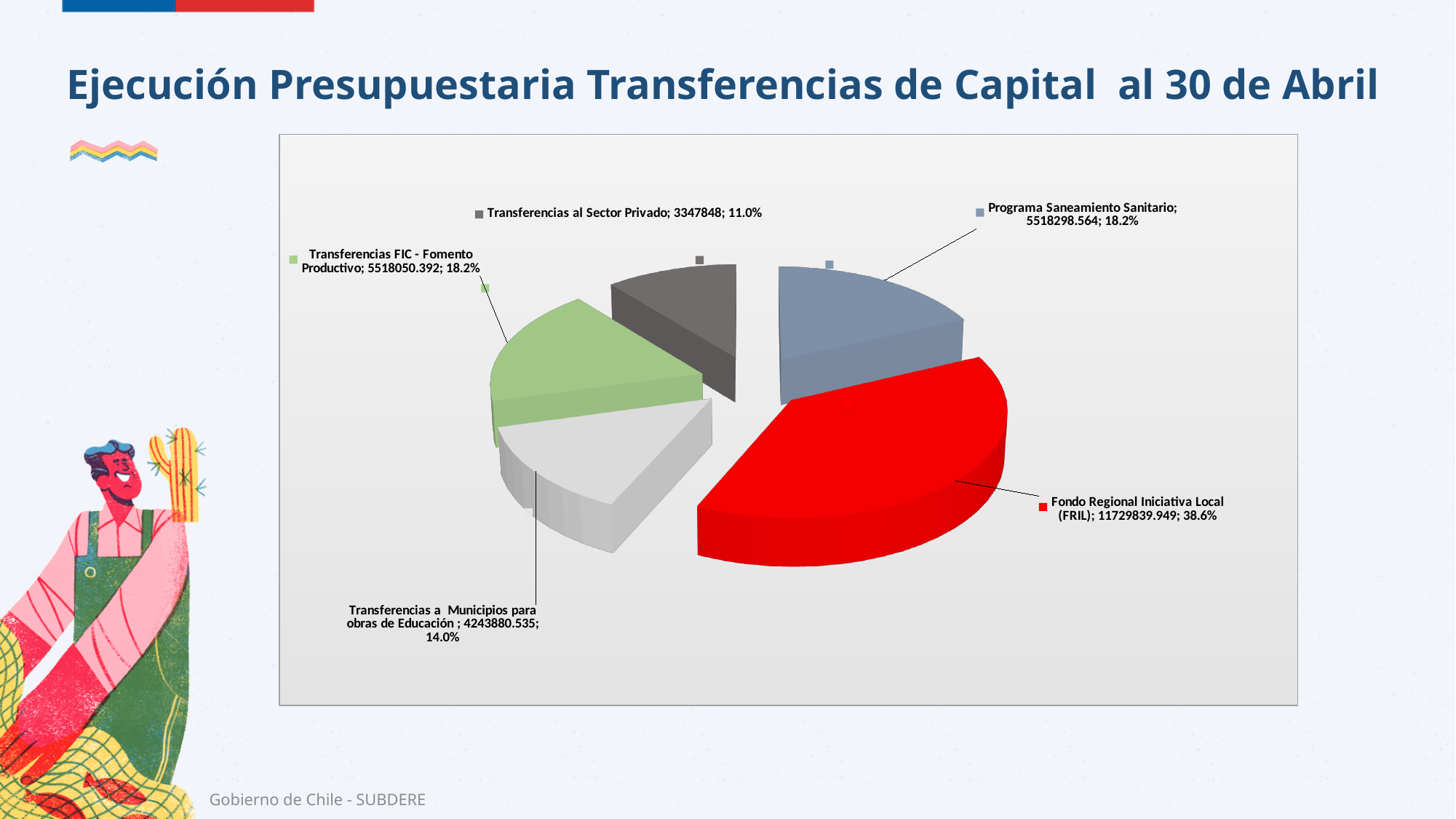
What is the value shown for Transferencias a Municipios para obras de Educación? 4243880.535 What is the difference in percentage share between Fondo Regional Iniciativa Local (FRIL) and Transferencias al Sector Privado? 27.6% What kind of chart is shown on the slide? Pie chart What percentage share does Programa Saneamiento Sanitario have in the pie chart? 18.2% What is the value shown for Fondo Regional Iniciativa Local (FRIL)? 11729839.949 Which is larger: the value for Fondo Regional Iniciativa Local (FRIL) or the value for Programa Saneamiento Sanitario? Fondo Regional Iniciativa Local (FRIL) What is the value shown for Transferencias al Sector Privado? 3347848 What percentage share does Fondo Regional Iniciativa Local (FRIL) have in the pie chart? 38.6% Which category has the largest slice of the pie chart? Fondo Regional Iniciativa Local (FRIL) What colour is the slice for Fondo Regional Iniciativa Local (FRIL)? Red How many slices does the pie chart have? 5 Which category has the smallest slice of the pie chart? Transferencias al Sector Privado